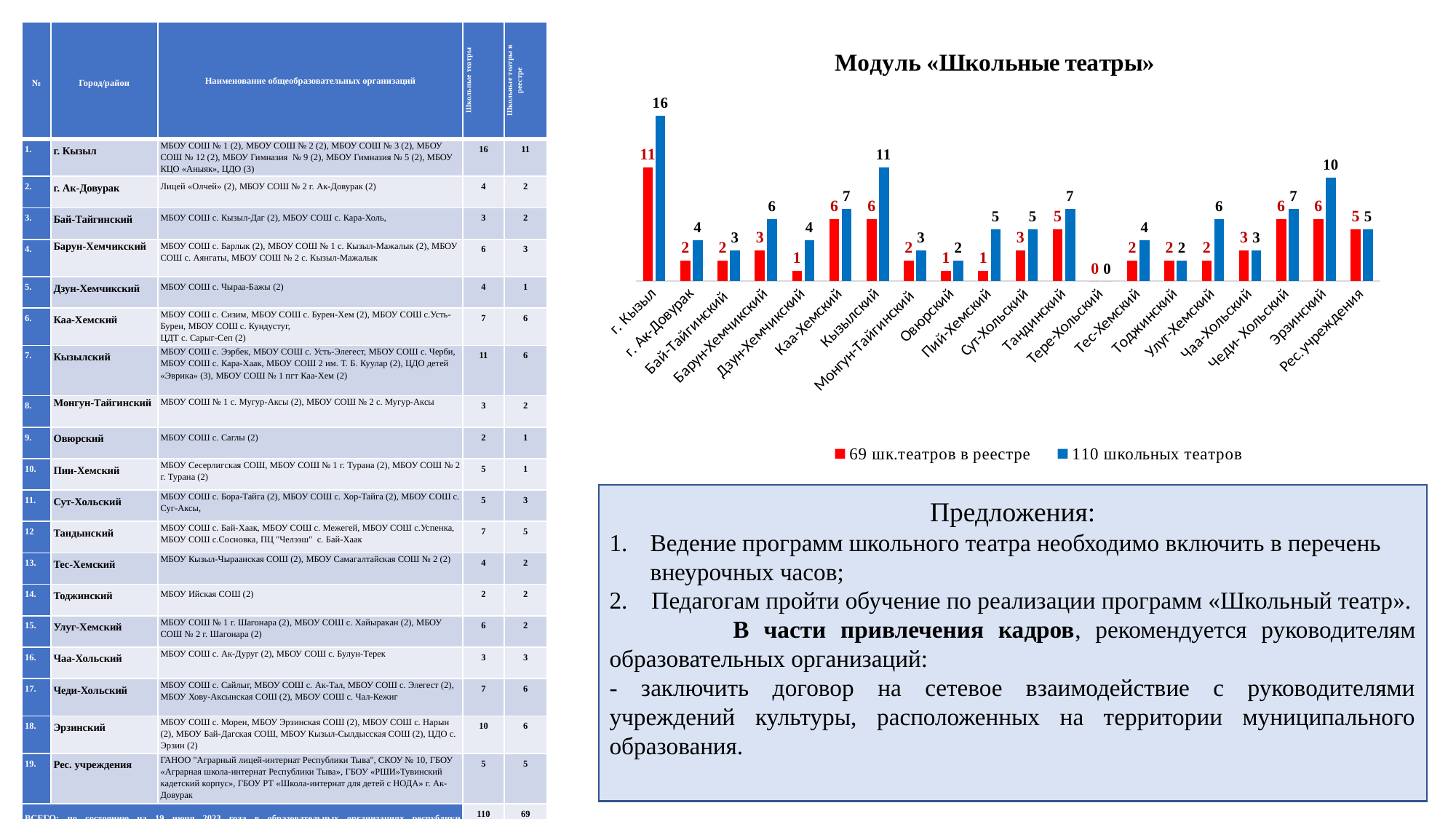
Which category has the highest value in the «110 школьных театров» series? г. Кызыл How many series does the legend of the chart list? 2 What is the value of the «110 школьных театров» series for г. Кызыл? 16 What is the difference between the «110 школьных театров» values for г. Кызыл and Эрзинский? 6 What is the value of the «69 шк.театров в реестре» series for Эрзинский? 6 How many categories are plotted along the x axis of the chart? 20 Which category has the lowest value in the «69 шк.театров в реестре» series? Тере-Хольский Which is larger for Улуг-Хемский: the «110 школьных театров» value or the «69 шк.театров в реестре» value? 110 школьных театров What is the difference between the «110 школьных театров» and «69 шк.театров в реестре» values for Кызылский? 5 Which colour represents the «69 шк.театров в реестре» series in the chart? red What type of chart is shown under the title «Модуль «Школьные театры»»? bar chart What is the value of the «110 школьных театров» series for Пий-Хемский? 5